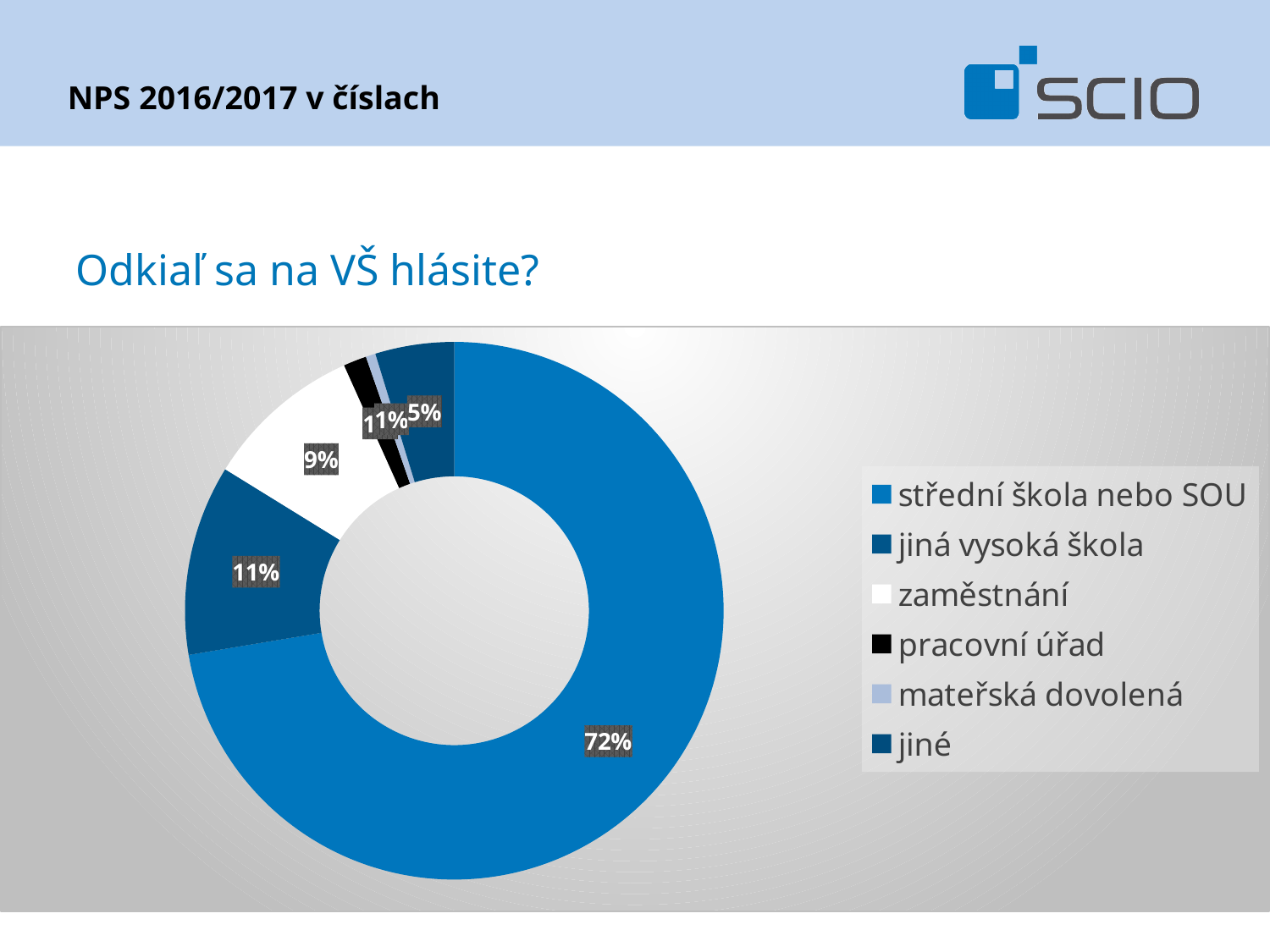
How many categories does the legend list? 6 What percentage of respondents are applying from střední škola nebo SOU? 72% What is the difference in percentage points between zaměstnání and jiné? 4 percentage points Which is larger: the share for jiná vysoká škola or for zaměstnání? jiná vysoká škola What type of chart is shown on the slide? Doughnut (pie) chart What share does jiná vysoká škola have in the chart? 11% Which category has the largest share of the chart? střední škola nebo SOU What is the title of the chart on the slide? Odkiaľ sa na VŠ hlásite? By how many percentage points does střední škola nebo SOU exceed jiná vysoká škola? 61 percentage points Which is larger: the share for zaměstnání or for jiné? zaměstnání What percentage is shown for zaměstnání? 9% What percentage is shown for the jiné category? 5%